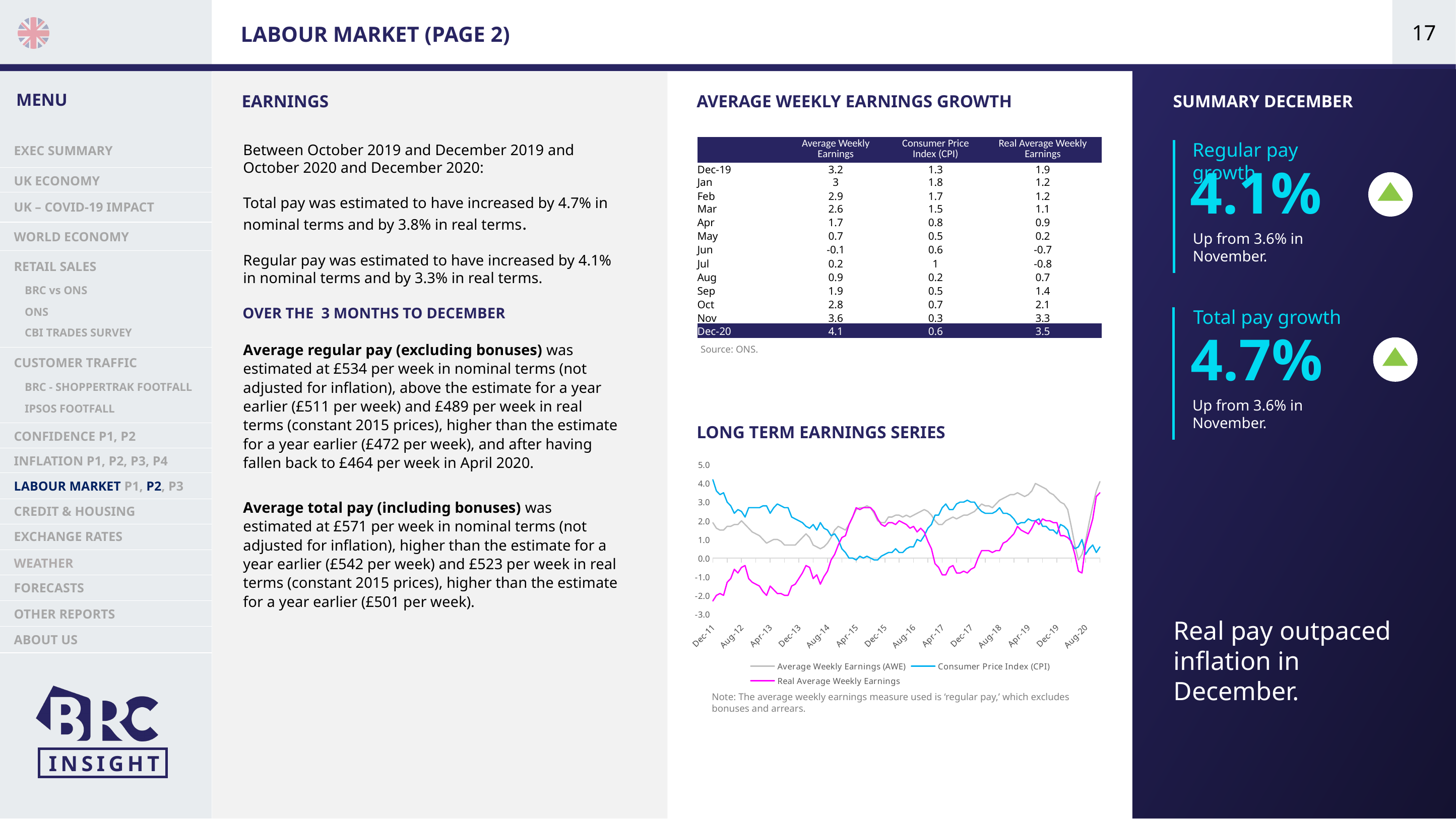
How many series does the legend of the Long Term Earnings Series chart list? 3 How many date labels are shown on the x axis of the Long Term Earnings Series chart? 14 In the Long Term Earnings Series chart, is the value for Consumer Price Index (CPI) at Aug-20 greater or less than 2.0? less In the Long Term Earnings Series chart, is the value for Average Weekly Earnings (AWE) at Apr-19 greater or less than 2.0? greater What kind of chart is the Long Term Earnings Series chart? line chart In the Long Term Earnings Series chart, is the value for Consumer Price Index (CPI) at Dec-11 greater or less than 3.0? greater In the Long Term Earnings Series chart, does the Real Average Weekly Earnings line rise or fall between Dec-11 and Apr-15? rise What colour is the Consumer Price Index (CPI) line in the Long Term Earnings Series chart? blue In the Long Term Earnings Series chart, does the Consumer Price Index (CPI) line rise or fall between Dec-11 and Dec-15? fall What is the title of the line chart on the slide? LONG TERM EARNINGS SERIES